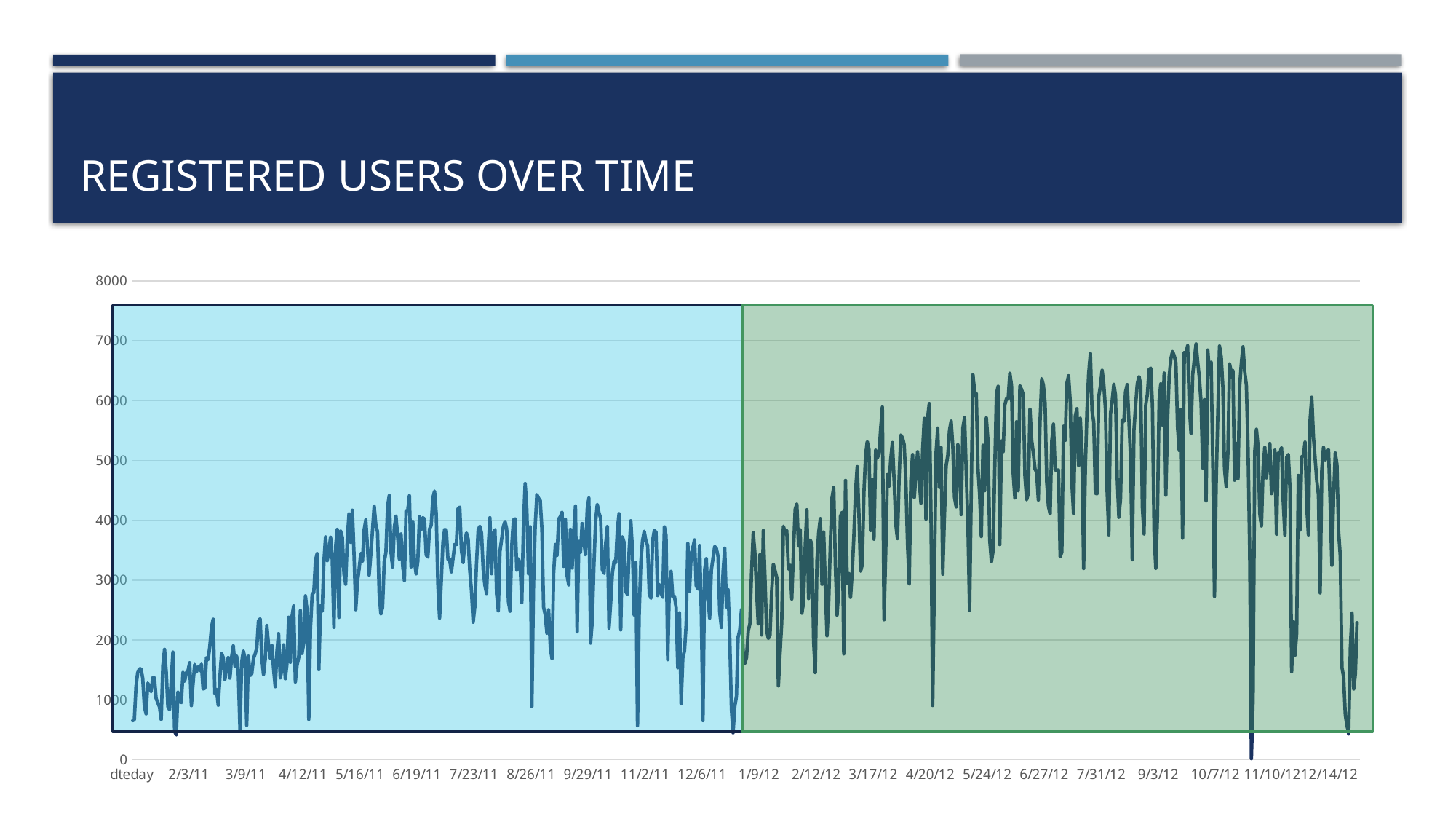
Are the values in the second half of 2012 generally higher or lower than the values in the first half of 2011? higher What kind of chart is shown on the slide? line chart Is the highest value reached on the chart greater or less than 6000? greater Which year has the higher peak value, 2011 or 2012? 2012 Overall, do the values rise or fall from the start of 2011 to the end of 2012? rise Does the line ever reach 8000 on the chart? no What is the highest value shown on the y axis of the chart? 8000 Is the highest value reached during 2011 greater or less than 5000? less What is the title of the chart on the slide? REGISTERED USERS OVER TIME